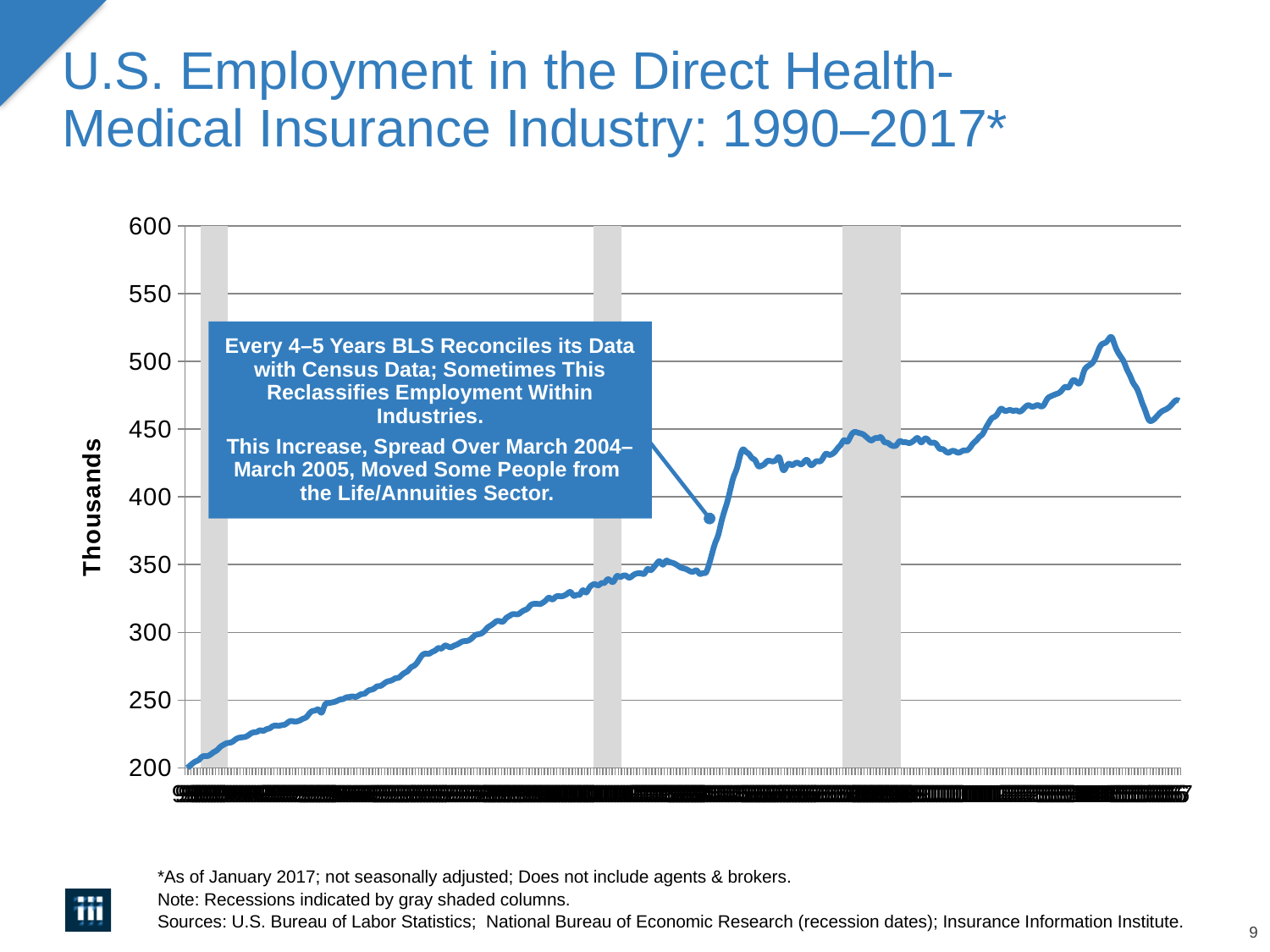
What kind of chart is shown on the slide? line chart Is the value at the end of the series (far right of the chart) greater or less than 450? greater Is the lowest point of the line greater or less than 250? less Is the highest point reached by the line greater or less than 500? greater What is the label on the vertical axis of the chart? Thousands How many gray shaded recession columns appear on the chart? 3 Overall, do the employment values rise or fall from the left of the x axis to the right? rise